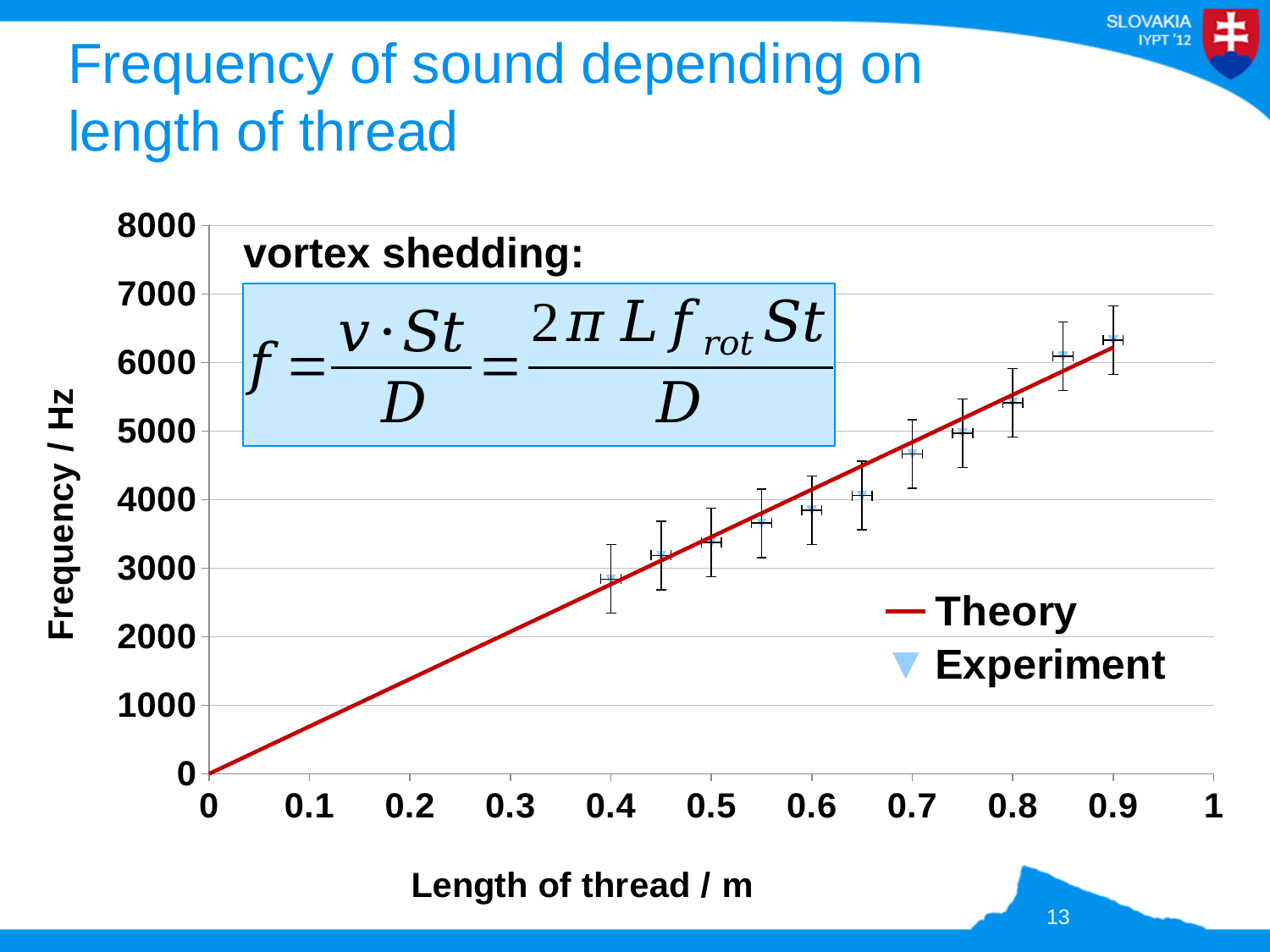
Do the Experiment values rise or fall as the length of thread increases? rise Is the Experiment frequency at a thread length of 0.55 m greater or less than 4000? less How many series does the chart legend list? 2 At which length of thread is the Experiment frequency highest? 0.9 What are the two series named in the legend? Theory and Experiment Is the Experiment frequency at a thread length of 0.7 m greater or less than 4000? greater Is the Experiment frequency at a thread length of 0.9 m greater or less than 6000? greater What is the label of the y axis? Frequency / Hz How many Experiment data points are plotted? 11 Which has the larger Experiment frequency: a thread length of 0.5 m or 0.8 m? 0.8 m At which length of thread is the Experiment frequency lowest? 0.4 What kind of chart is shown on the slide? scatter chart